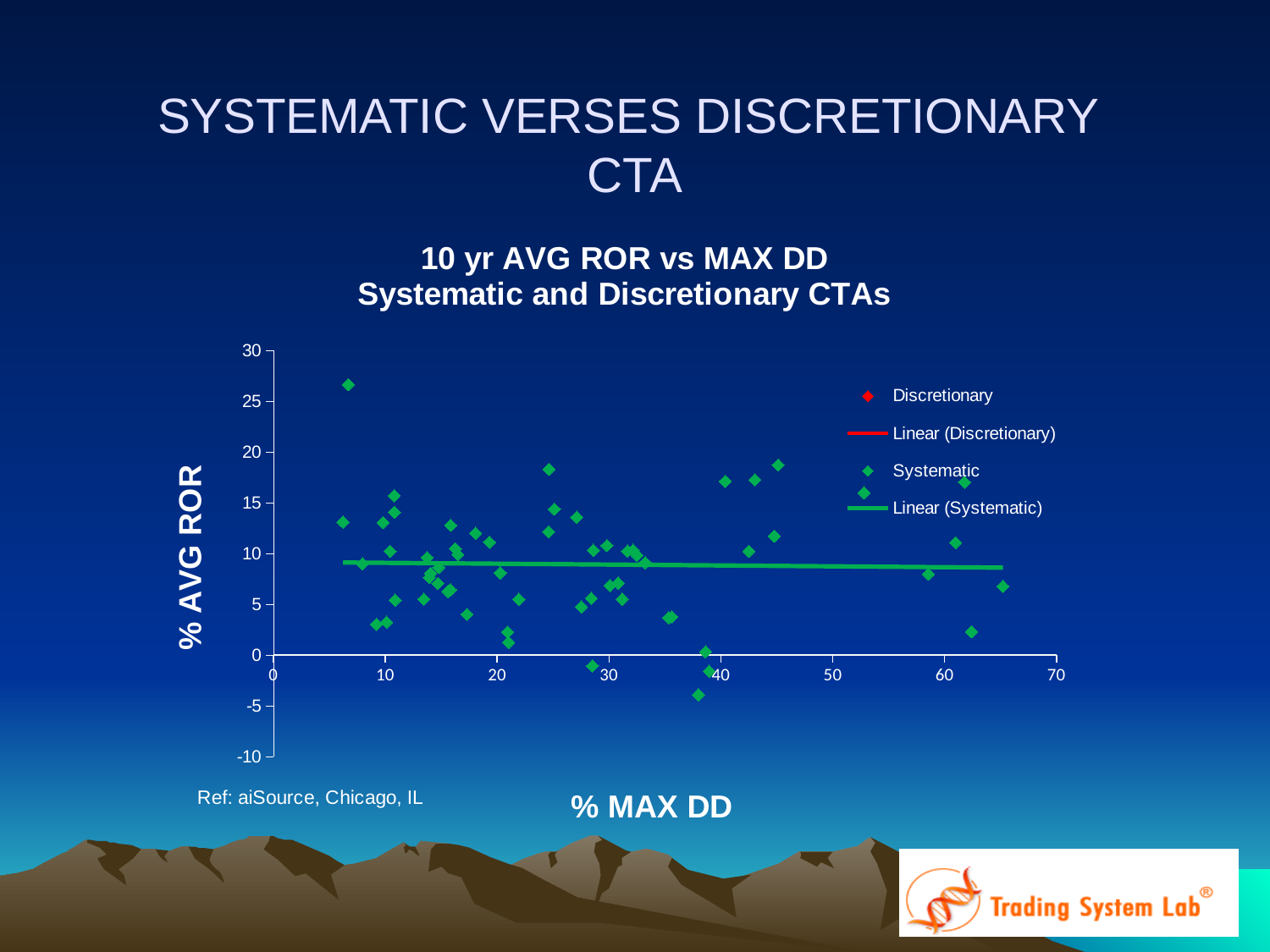
Is the highest Systematic point on the chart greater or less than 25 on the % AVG ROR axis? greater What label is shown on the vertical axis of the chart? % AVG ROR What kind of chart is shown on the slide? Scatter chart Is the lowest Systematic point on the chart greater or less than 0 on the % AVG ROR axis? less Is the Systematic point with the highest % AVG ROR greater or less than 10 on the % MAX DD axis? less How many entries does the chart legend list? 4 What is the title of the chart? 10 yr AVG ROR vs MAX DD Systematic and Discretionary CTAs